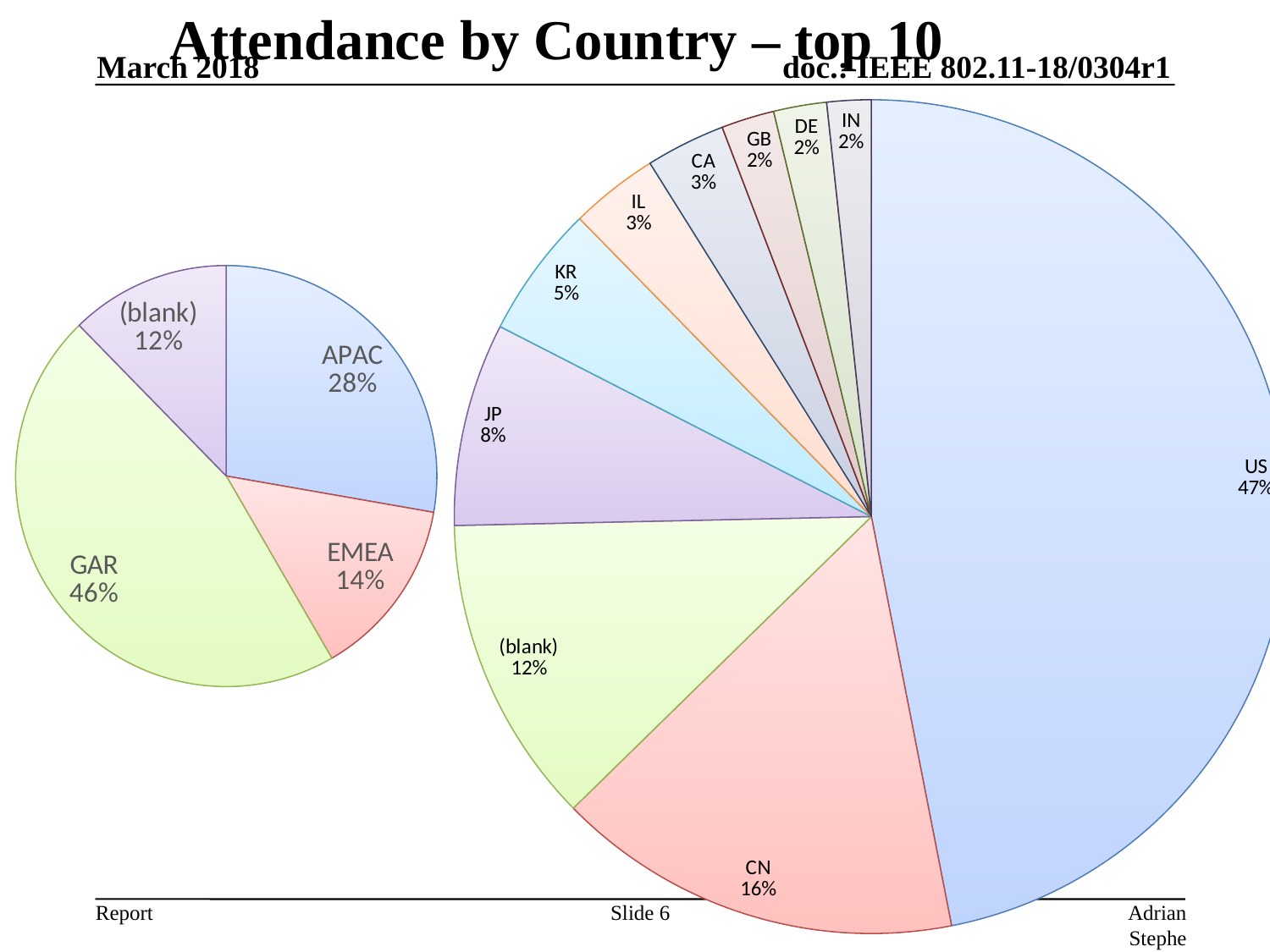
In the small pie chart on the left, what is the difference between the APAC share and the EMEA share? 14% In the large pie chart on the right, what share does US have? 47% How many slices does the small pie chart on the left have? 4 How many slices does the large pie chart on the right have? 10 In the large pie chart on the right, which country has the largest slice? US In the small pie chart on the left, what share does GAR have? 46% What kind of chart is the large chart on the right of the slide? pie chart In the large pie chart on the right, which is larger, JP or KR? JP In the large pie chart on the right, what is the difference between the US share and the CN share? 31% In the small pie chart on the left, which category has the smallest slice? (blank) What is the title of the slide containing the charts? Attendance by Country – top 10 In the large pie chart on the right, what share does CN have? 16%